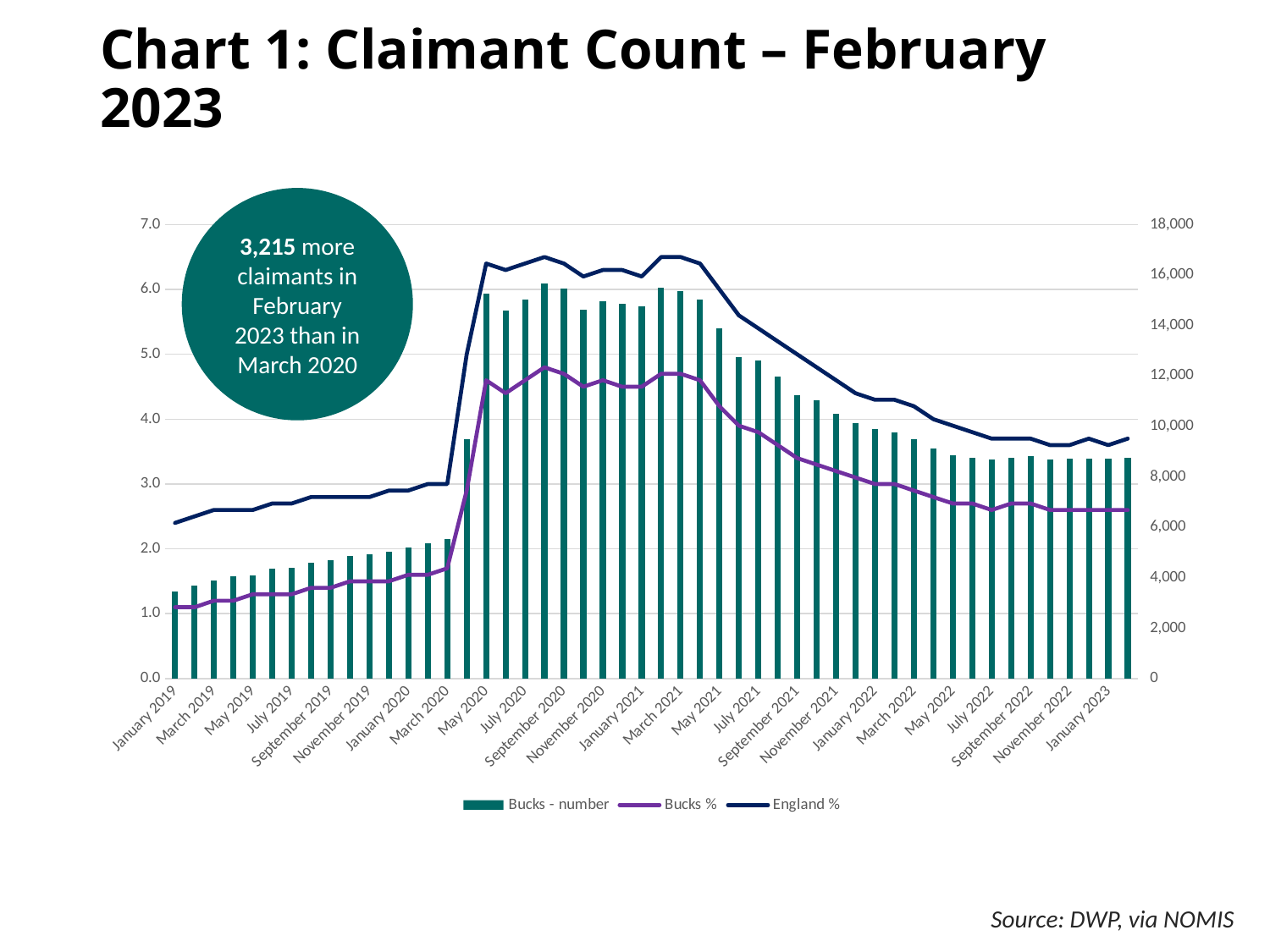
Which series is plotted as bars? Bucks - number What kind of chart is this? Combined bar and line chart Does the Bucks % line rise or fall between May 2021 and January 2023? Fall How many series does the legend list? 3 According to the callout, how many more claimants were there in February 2023 than in March 2020? 3,215 Is the Bucks - number value for January 2019 greater or less than 4,000? less Is the England % value for January 2019 greater or less than 3.0? less Is the Bucks - number value for May 2020 greater or less than 14,000? greater Which is larger, the Bucks - number value for March 2020 or for May 2020? May 2020 In May 2020, which is higher, the England % or the Bucks %? England %